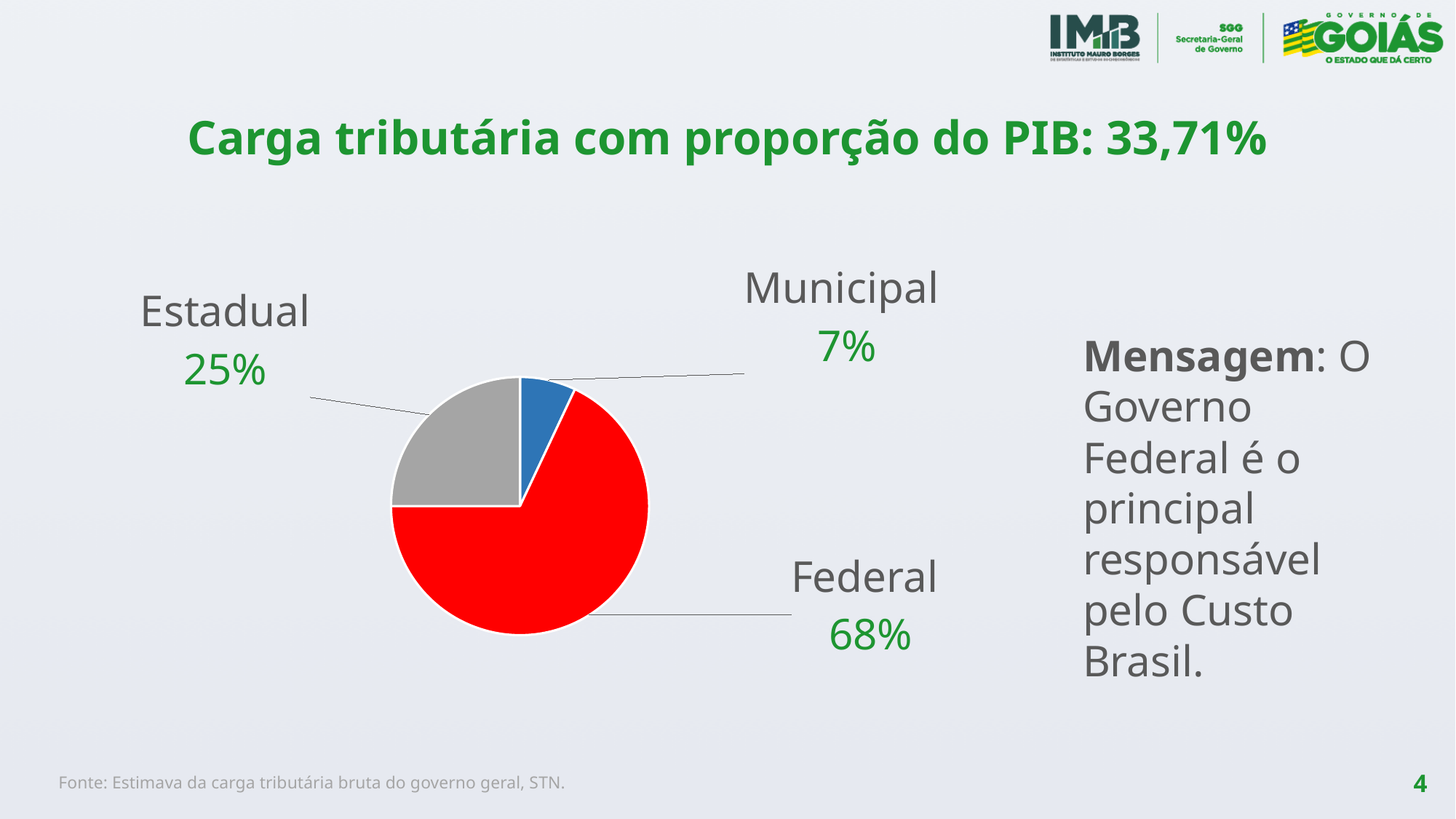
What share of the pie does Estadual have? 25% What colour is the Federal slice of the pie? Red What is the title of the slide containing the pie chart? Carga tributária com proporção do PIB: 33,71% What share of the pie does Federal have? 68% How many slices does the pie chart have? 3 Which is larger, the Estadual slice or the Municipal slice? Estadual What type of chart is shown on the slide? Pie chart Which slice of the pie is the smallest? Municipal Which slice of the pie is the largest? Federal What is the difference in percentage points between the Estadual and Municipal slices? 18 What share of the pie does Municipal have? 7% What is the difference in percentage points between the Federal and Estadual slices? 43